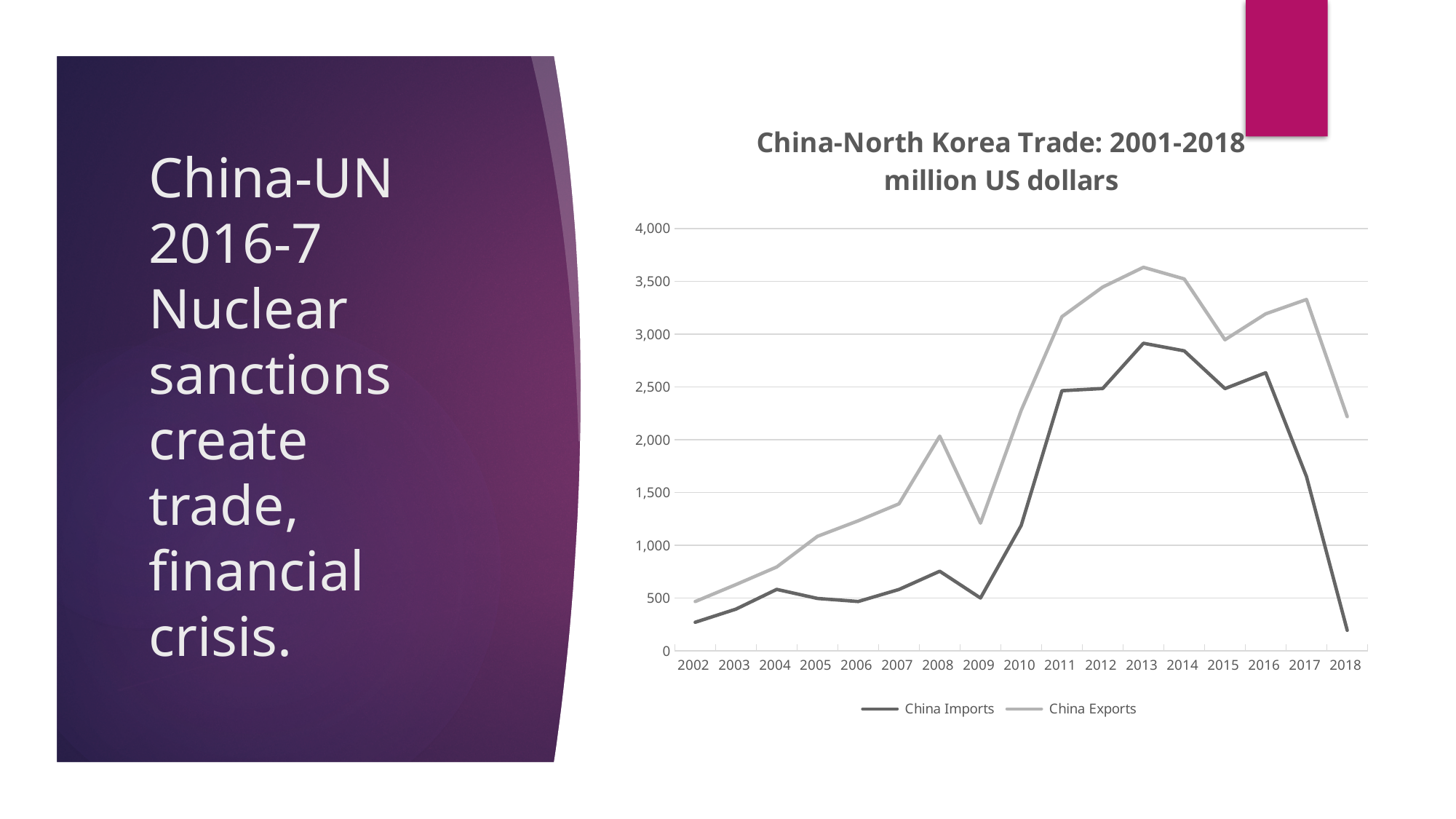
Is the value for China Exports in 2013 greater or less than 3,500? greater In which year is China Exports at its lowest value? 2002 Which is larger for China Imports: the value in 2010 or the value in 2011? 2011 Does China Imports rise or fall from 2016 to 2018? fall How many years are plotted along the x axis? 17 What kind of chart is shown on the slide? line chart What is the title of the chart? China-North Korea Trade: 2001-2018 million US dollars In which year does China Exports reach its highest value? 2013 Is the value for China Imports in 2011 greater or less than 2,000? greater How many series does the legend list? 2 Is the value for China Imports in 2018 greater or less than 500? less In 2008, which is larger: China Imports or China Exports? China Exports